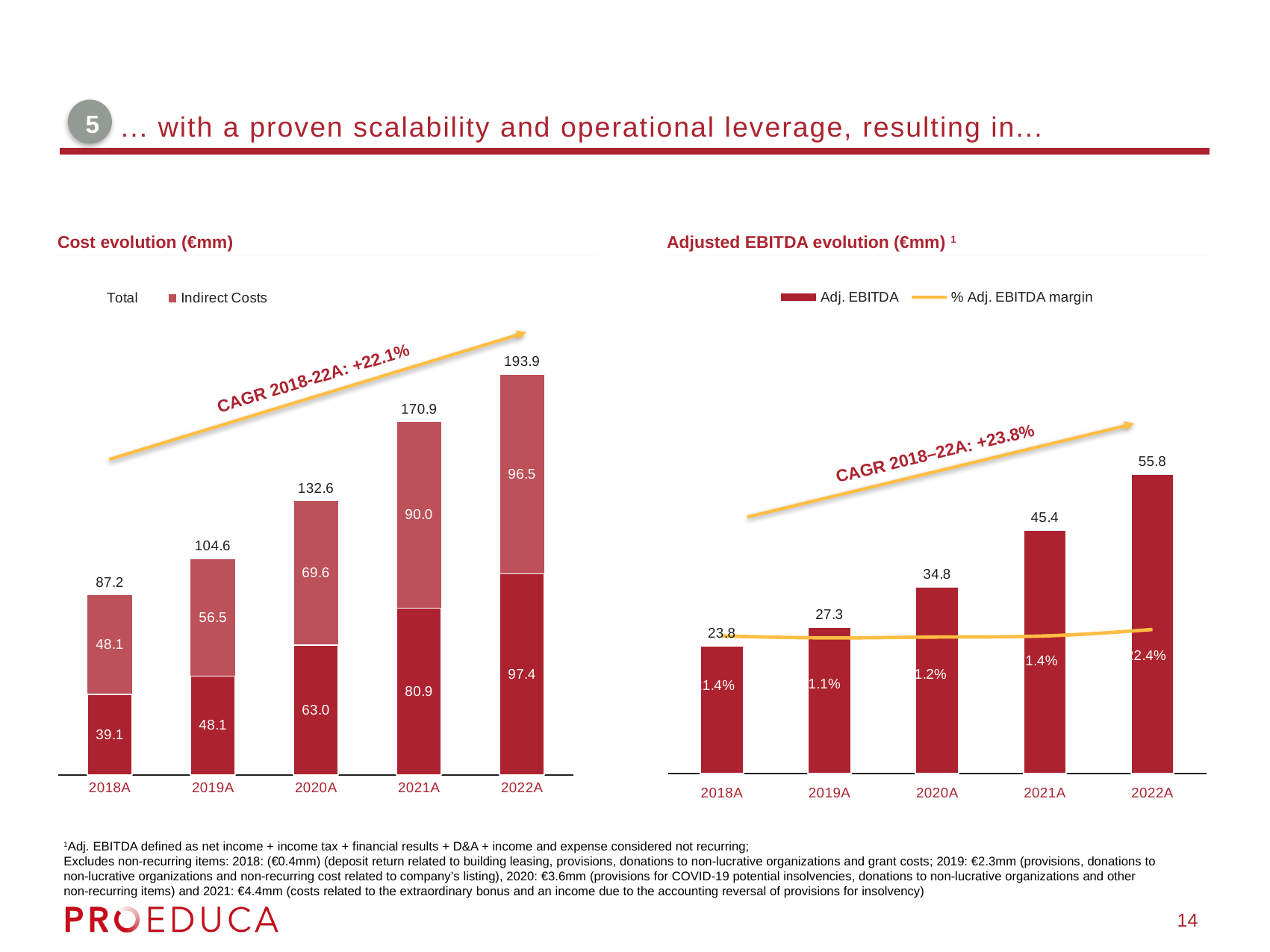
In the Cost evolution chart, what is the total cost for 2020A? 132.6 In the Cost evolution chart, what is the Indirect Costs value for 2021A? 90.0 In the Adjusted EBITDA evolution chart, what is the Adj. EBITDA for 2021A? 45.4 In the Adjusted EBITDA evolution chart, what is the difference between Adj. EBITDA in 2022A and 2021A? 10.4 How many series does the legend of the Adjusted EBITDA evolution chart list? 2 In the Cost evolution chart, what is the difference between the total cost in 2022A and in 2018A? 106.7 How many years are shown on the x axis of the Cost evolution chart? 5 In the Adjusted EBITDA evolution chart, do the Adj. EBITDA values rise or fall from 2018A to 2022A? Rise What kind of chart is the Cost evolution chart? Stacked bar chart In the Cost evolution chart, which year has the highest total cost? 2022A In the Cost evolution chart, which is larger: Indirect Costs in 2019A or Indirect Costs in 2020A? 2020A In the Adjusted EBITDA evolution chart, which year has the lowest Adj. EBITDA? 2018A